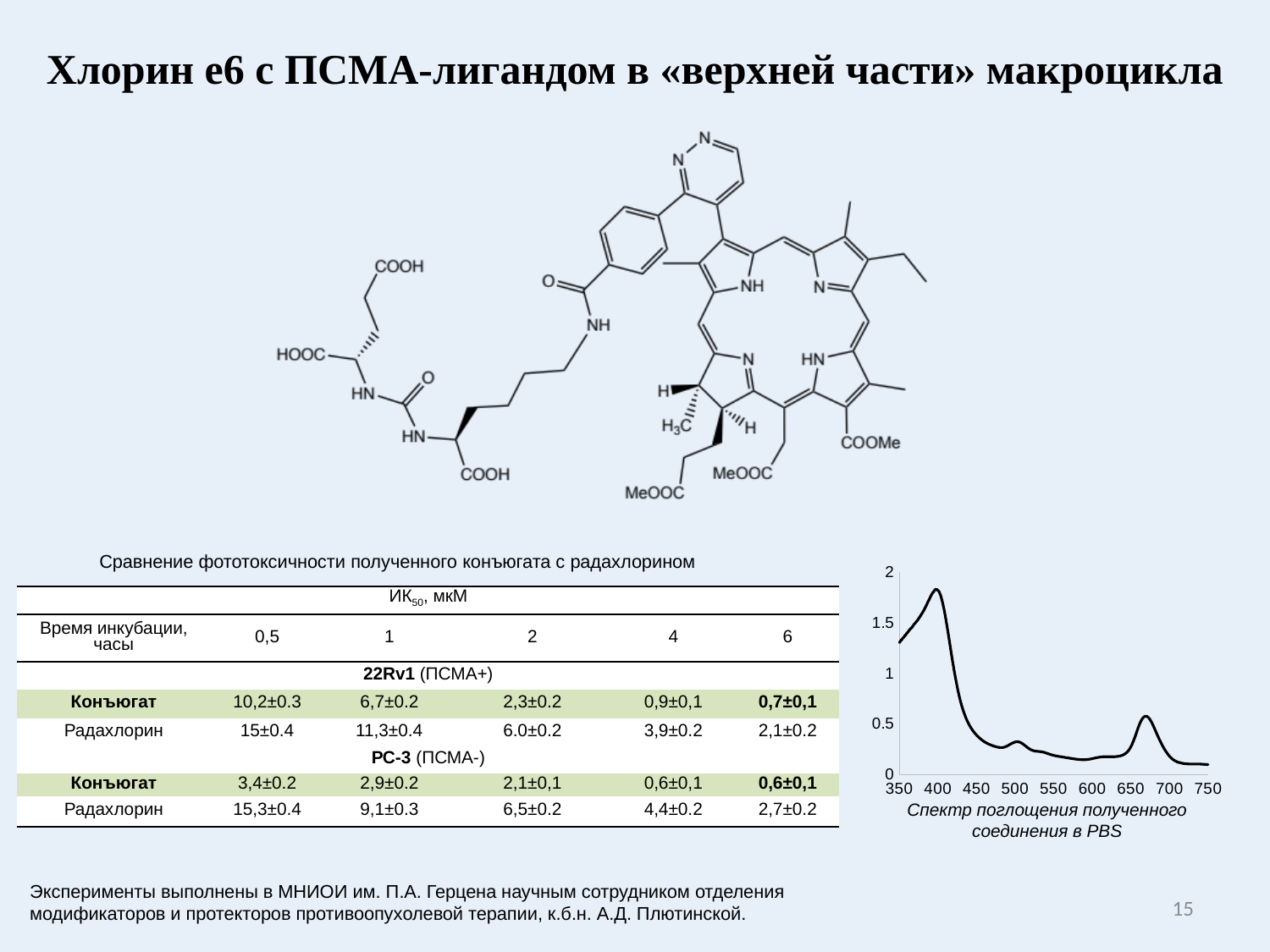
In the absorption spectrum chart, is the value at 600 greater or less than 0.5? less In the absorption spectrum chart, is the value at 750 greater or less than 0.5? less What kind of chart is shown at the bottom right of the slide? line chart In the absorption spectrum chart, does the curve rise or fall between 400 and 600 on the x axis? fall In the absorption spectrum chart, is the value at 550 greater or less than 0.5? less What is the highest tick value shown on the y axis of the absorption spectrum chart? 2 What is the caption of the chart at the bottom right of the slide? Спектр поглощения полученного соединения в PBS In the absorption spectrum chart, which is larger: the value at 400 or the value at 670? the value at 400 In the absorption spectrum chart, does the curve rise or fall between 350 and 400 on the x axis? rise